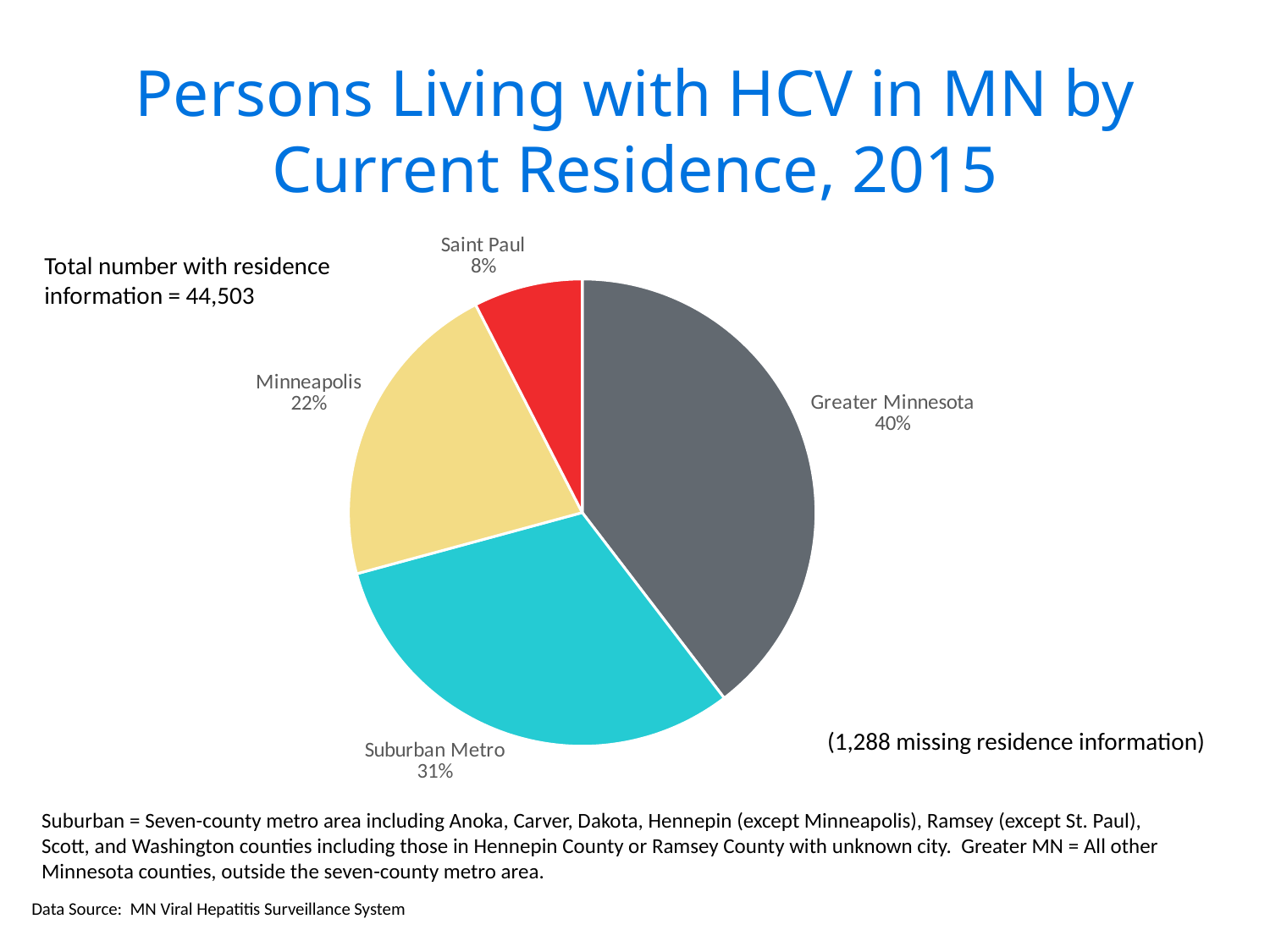
What is the difference in percentage points between Greater Minnesota and Suburban Metro? 9 What colour is the Suburban Metro slice? Teal What share of the pie does Greater Minnesota represent? 40% Which is larger, the share for Minneapolis or the share for Saint Paul? Minneapolis What percentage is shown for Minneapolis? 22% What type of chart is shown on the slide? Pie chart How many residence categories are shown in the pie chart? 4 Which residence category has the largest share? Greater Minnesota Which residence category has the smallest share? Saint Paul What percentage is shown for Saint Paul? 8% What percentage is shown for Suburban Metro? 31% What is the total number of persons with residence information stated on the slide? 44,503